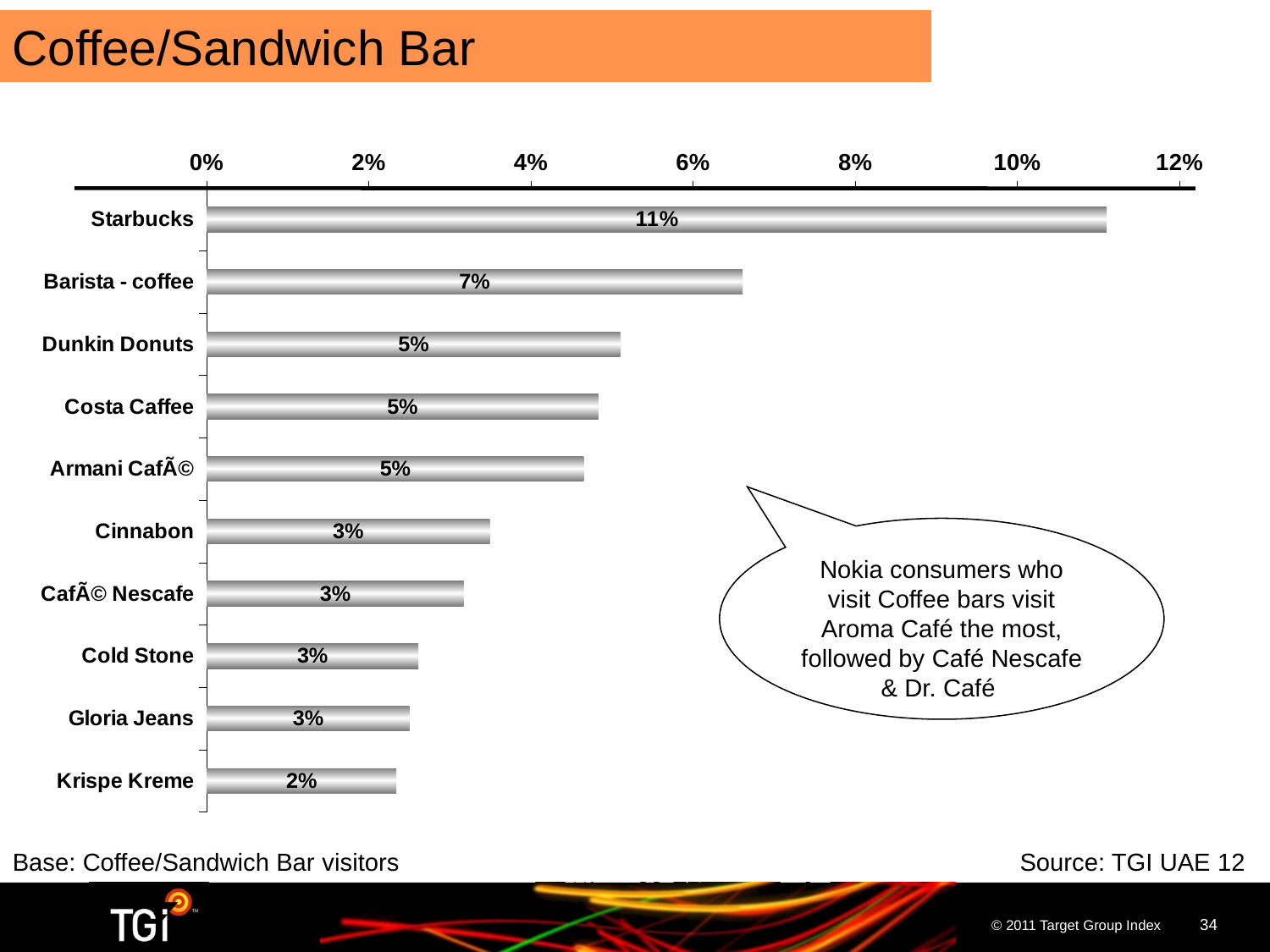
What kind of chart is shown on the slide? bar chart What is the difference between the values for Starbucks and Barista - coffee? 4 percentage points What is the value for Starbucks? 11% Which is larger, the value for Barista - coffee or the value for Dunkin Donuts? Barista - coffee Which category has the lowest value? Krispe Kreme How many categories are shown in the chart? 10 Is the value for Starbucks greater or less than 10%? greater What is the value for Barista - coffee? 7% What is the value for Krispe Kreme? 2% What is the value for Dunkin Donuts? 5% Which category has the highest value? Starbucks What is the value for Cinnabon? 3%